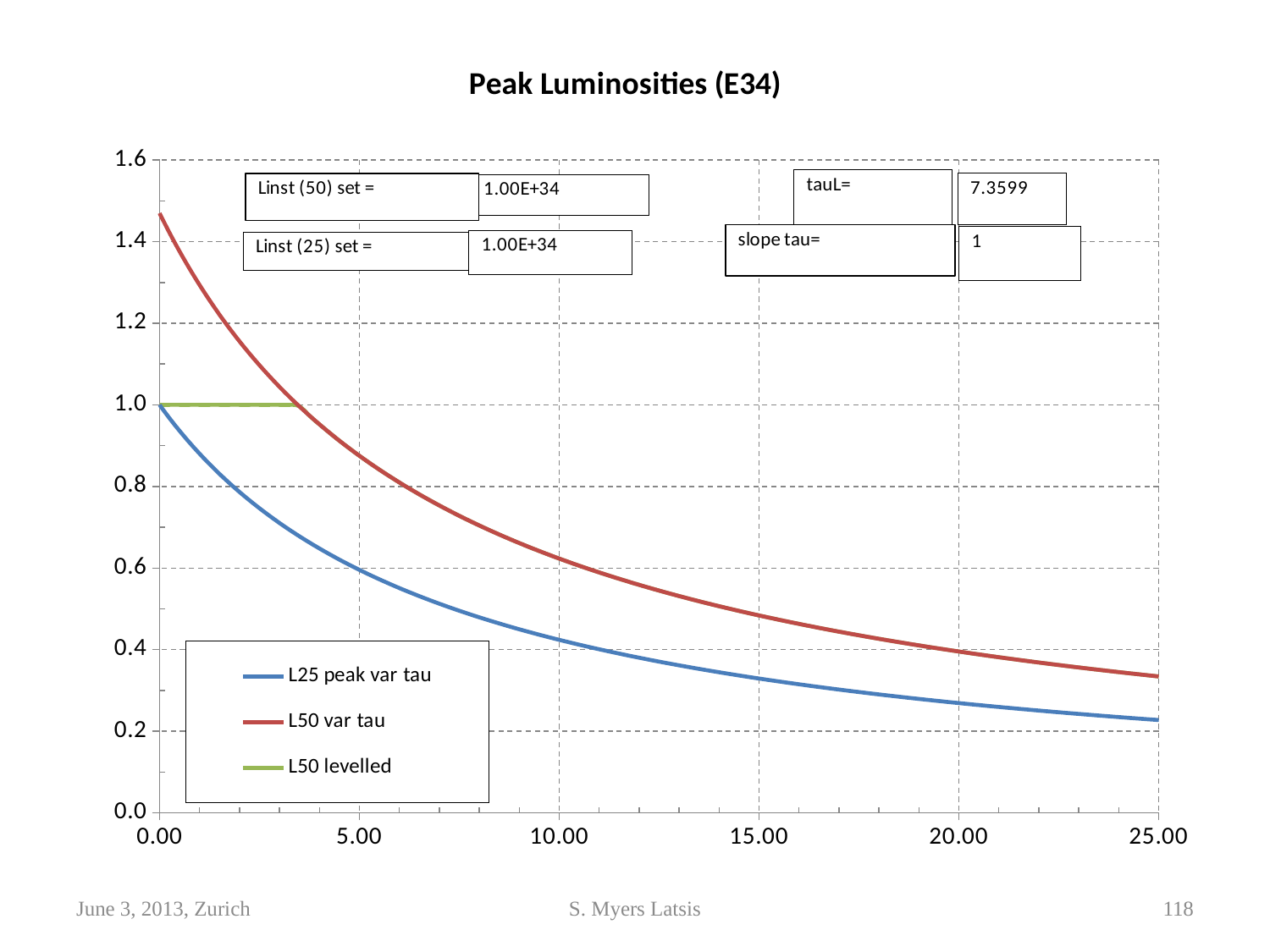
At what constant value does the L50 levelled series sit? 1.0 Is the value of L50 var tau at x = 0.00 greater or less than 1.4? greater Is the value of L50 var tau at x = 5.00 greater or less than 0.8? greater Is the value of L25 peak var tau at x = 25.00 greater or less than 0.4? less How many series does the legend list? 3 What is the value of the L25 peak var tau series at x = 0.00? 1.0 At x = 10.00, which is larger: L50 var tau or L25 peak var tau? L50 var tau Which colour is used for the L50 var tau series? red What kind of chart is shown on the slide? line chart Which series has the highest value at x = 0.00? L50 var tau What is the title of the chart? Peak Luminosities (E34) Does the L50 var tau series rise or fall as the x axis increases? fall